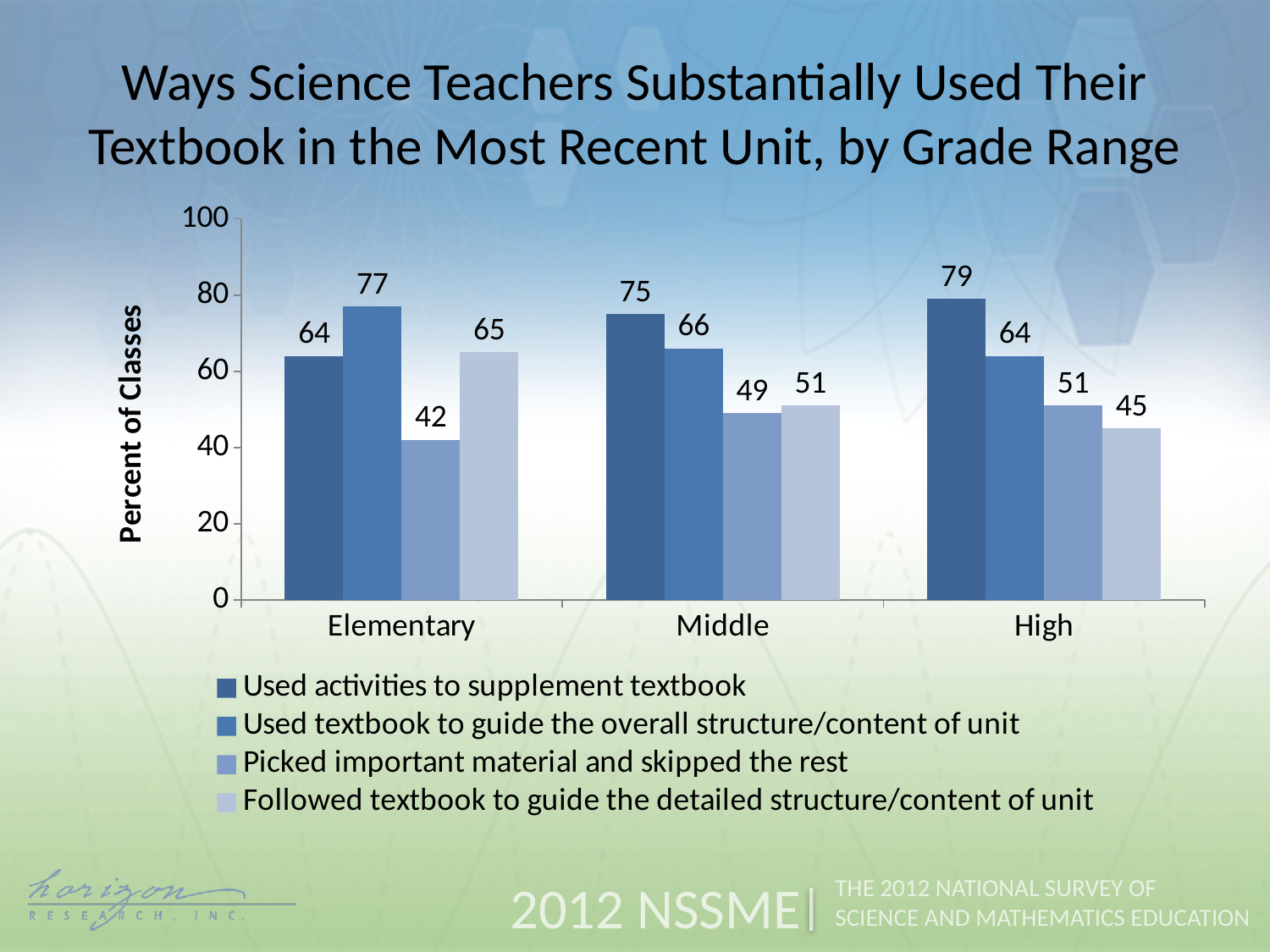
Which grade range has the highest value for 'Used activities to supplement textbook'? High How many series does the legend list? 4 What kind of chart is shown on the slide? Bar chart What is the value for 'Followed textbook to guide the detailed structure/content of unit' in the High grade range? 45 What is the label of the y axis? Percent of Classes How many grade ranges are shown on the x axis? 3 Which is larger for Middle classes: 'Used activities to supplement textbook' or 'Used textbook to guide the overall structure/content of unit'? Used activities to supplement textbook Is the value for 'Picked important material and skipped the rest' in Elementary greater or less than 60? less Which grade range has the lowest value for 'Followed textbook to guide the detailed structure/content of unit'? High What percent of elementary classes used activities to supplement the textbook? 64 What is the value for 'Picked important material and skipped the rest' in the Middle grade range? 49 What is the difference between 'Used textbook to guide the overall structure/content of unit' for Elementary and for High? 13